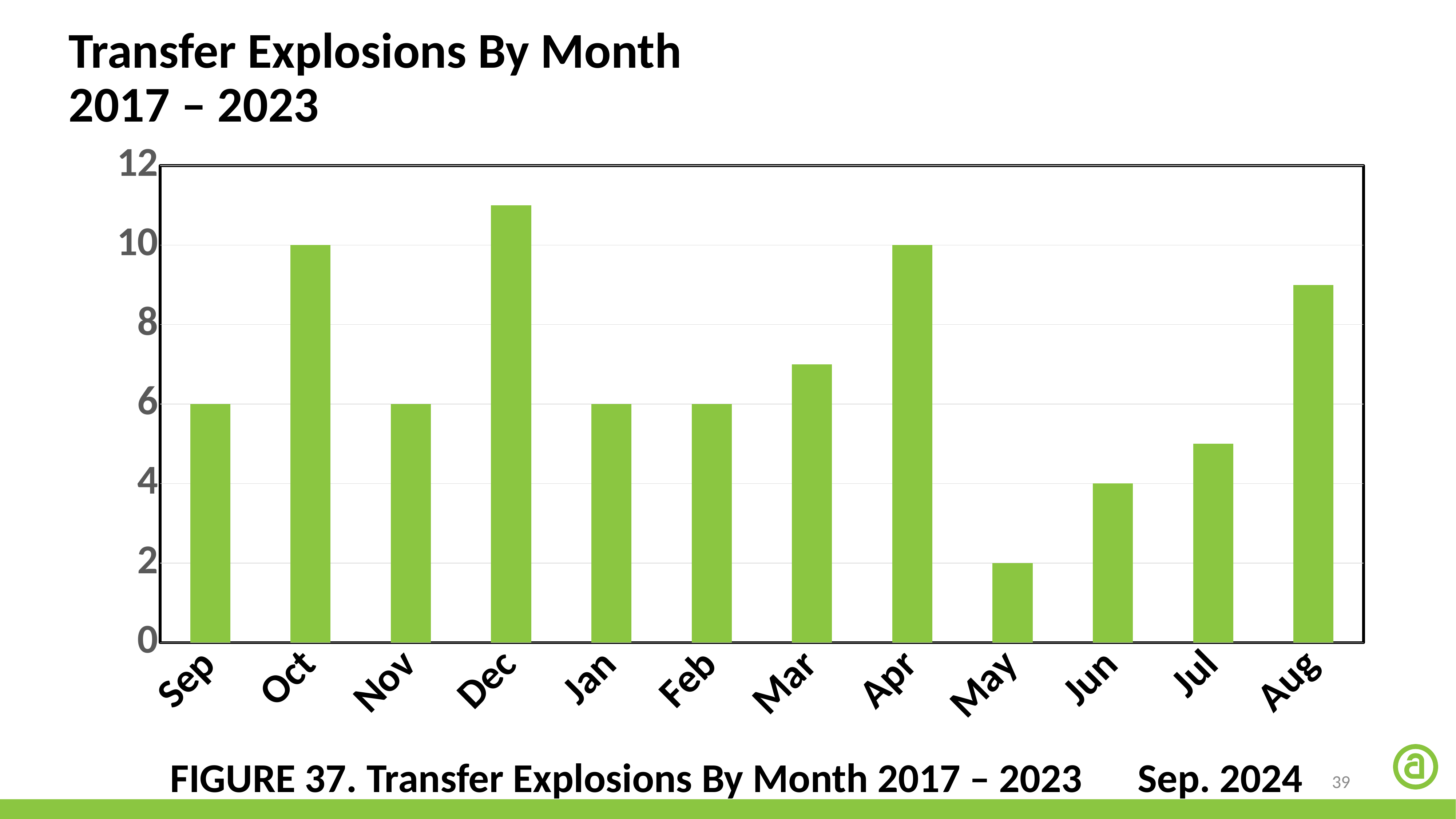
What kind of chart is shown on the slide? bar chart What is the value for Sep? 6 How many months are shown on the x axis of the chart? 12 What is the value for May? 2 Which month has the highest value? Dec Is the value for Aug greater or less than 8? greater What is the value for Oct? 10 Which month has the lowest value? May What is the value for Jun? 4 Is the value for Dec greater or less than 10? greater Which is larger, the value for Mar or the value for Jul? Mar What is the difference between the values for Oct and Sep? 4